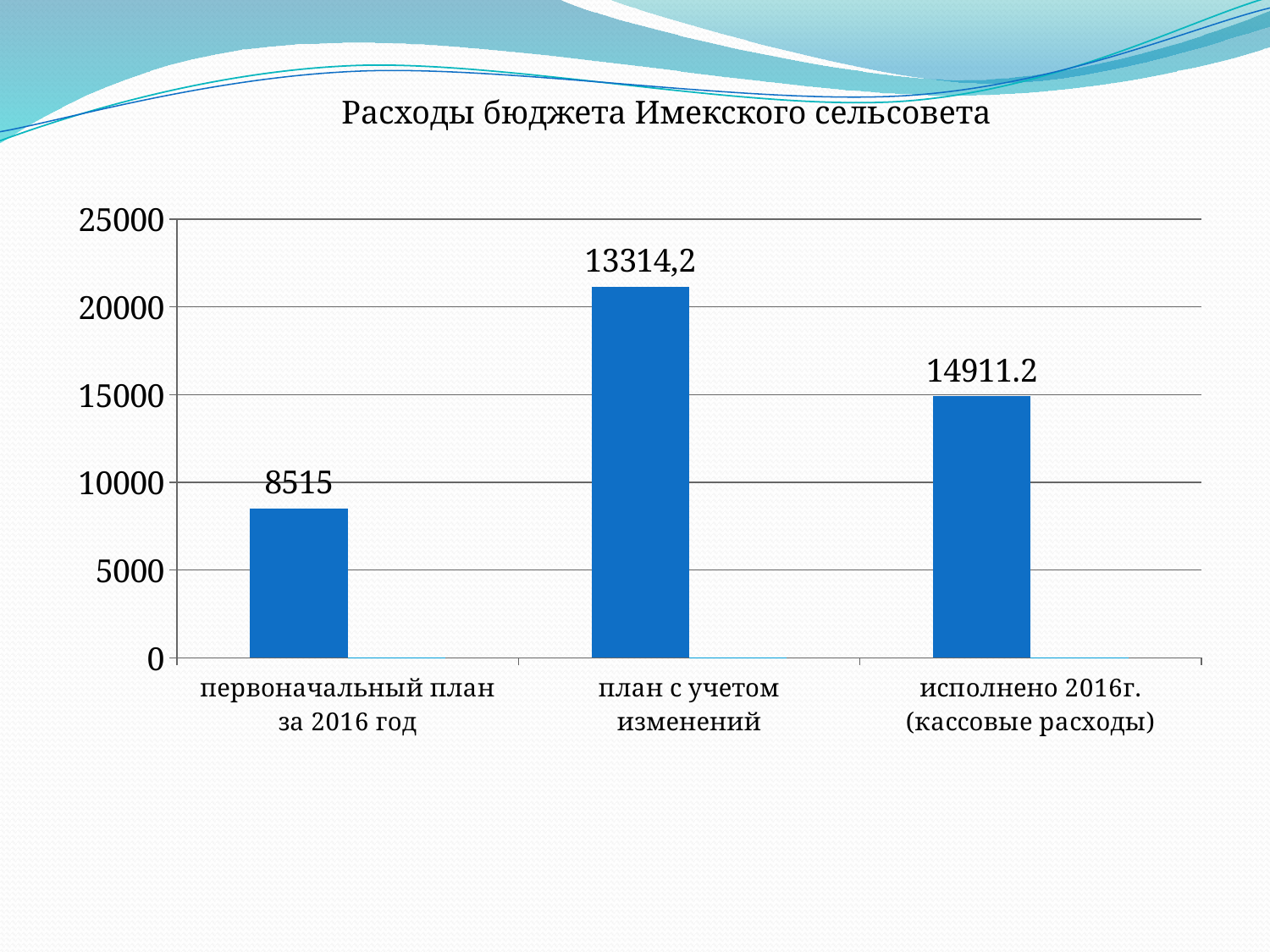
Which category has the lowest value? первоначальный план за 2016 год How many categories are shown on the chart? 3 What is the value for "исполнено 2016г. (кассовые расходы)"? 14911.2 What is the highest value shown on the vertical axis? 25000 What is the title of the chart? Расходы бюджета Имекского сельсовета Is the value for "первоначальный план за 2016 год" greater or less than 10000? less What is the value for "первоначальный план за 2016 год"? 8515 What kind of chart is shown on the slide? bar chart What is the difference between the values for "исполнено 2016г. (кассовые расходы)" and "первоначальный план за 2016 год"? 6396.2 What is the value for "план с учетом изменений"? 13314,2 Which is larger: the value for "исполнено 2016г. (кассовые расходы)" or for "первоначальный план за 2016 год"? исполнено 2016г. (кассовые расходы)